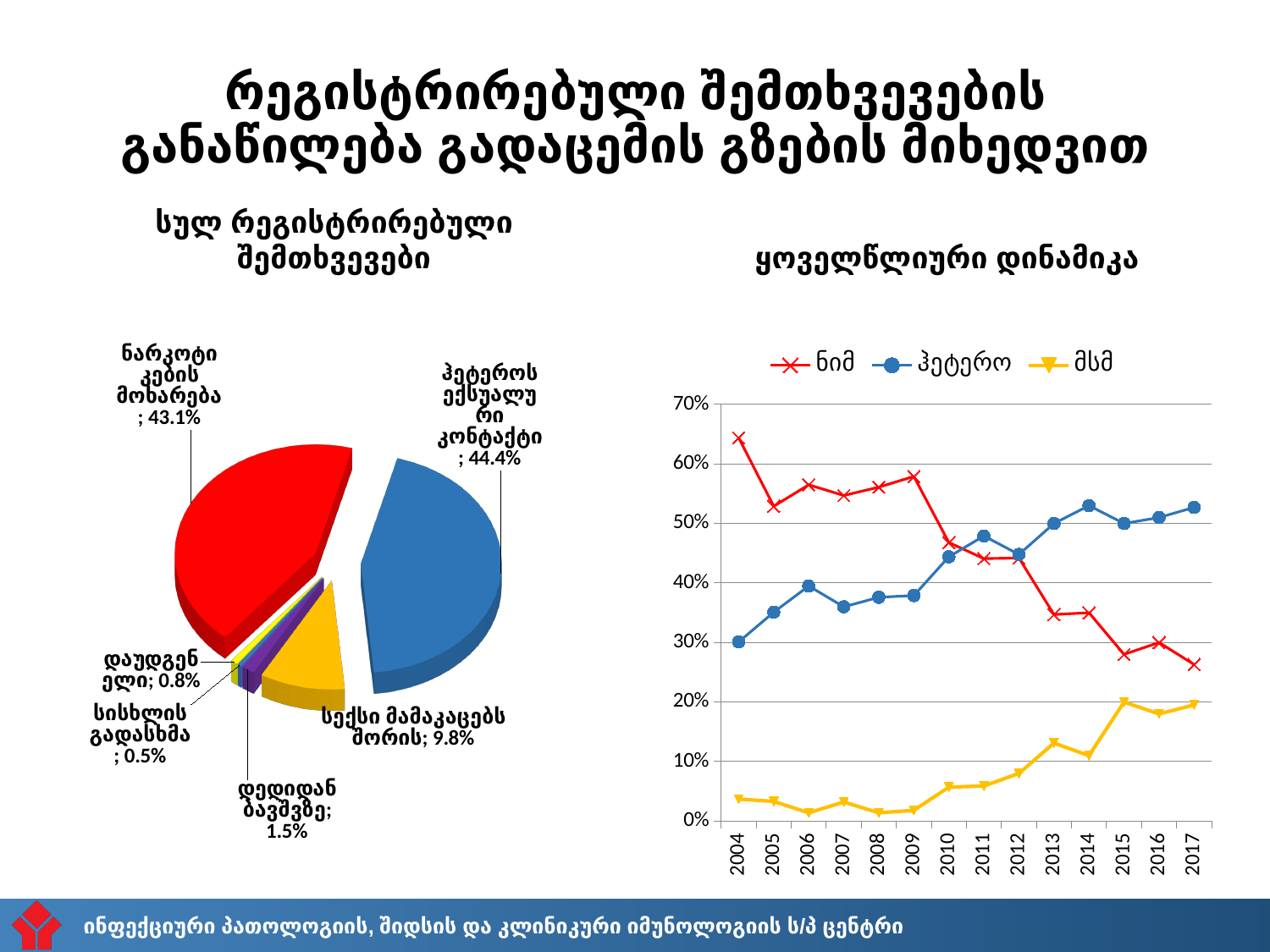
In the pie chart 'სულ რეგისტრირებული შემთხვევები', what share is labelled for ჰეტეროსექსუალური კონტაქტი? 44.4% In the pie chart 'სულ რეგისტრირებული შემთხვევები', what share is labelled for სექსი მამაკაცებს შორის? 9.8% In the pie chart 'სულ რეგისტრირებული შემთხვევები', which category has the smallest share? სისხლის გადასხმა In the pie chart 'სულ რეგისტრირებული შემთხვევები', what is the difference between the shares of ჰეტეროსექსუალური კონტაქტი and ნარკოტიკების მოხმარება? 1.3% In the line chart 'ყოველწლიური დინამიკა', does the ნიმ series rise or fall from 2004 to 2017? fall In the line chart 'ყოველწლიური დინამიკა', how many series does the legend list? 3 In the line chart 'ყოველწლიური დინამიკა', is the value for ნიმ in 2004 greater or less than 60%? greater In the line chart 'ყოველწლიური დინამიკა', is the value for ნიმ in 2017 greater or less than 30%? less In the line chart 'ყოველწლიური დინამიკა', which series has the higher value in 2017, ნიმ or ჰეტერო? ჰეტერო What kind of chart is 'ყოველწლიური დინამიკა'? line chart In the pie chart 'სულ რეგისტრირებული შემთხვევები', how many slices are there? 6 In the pie chart 'სულ რეგისტრირებული შემთხვევები', what share is labelled for ნარკოტიკების მოხმარება? 43.1%